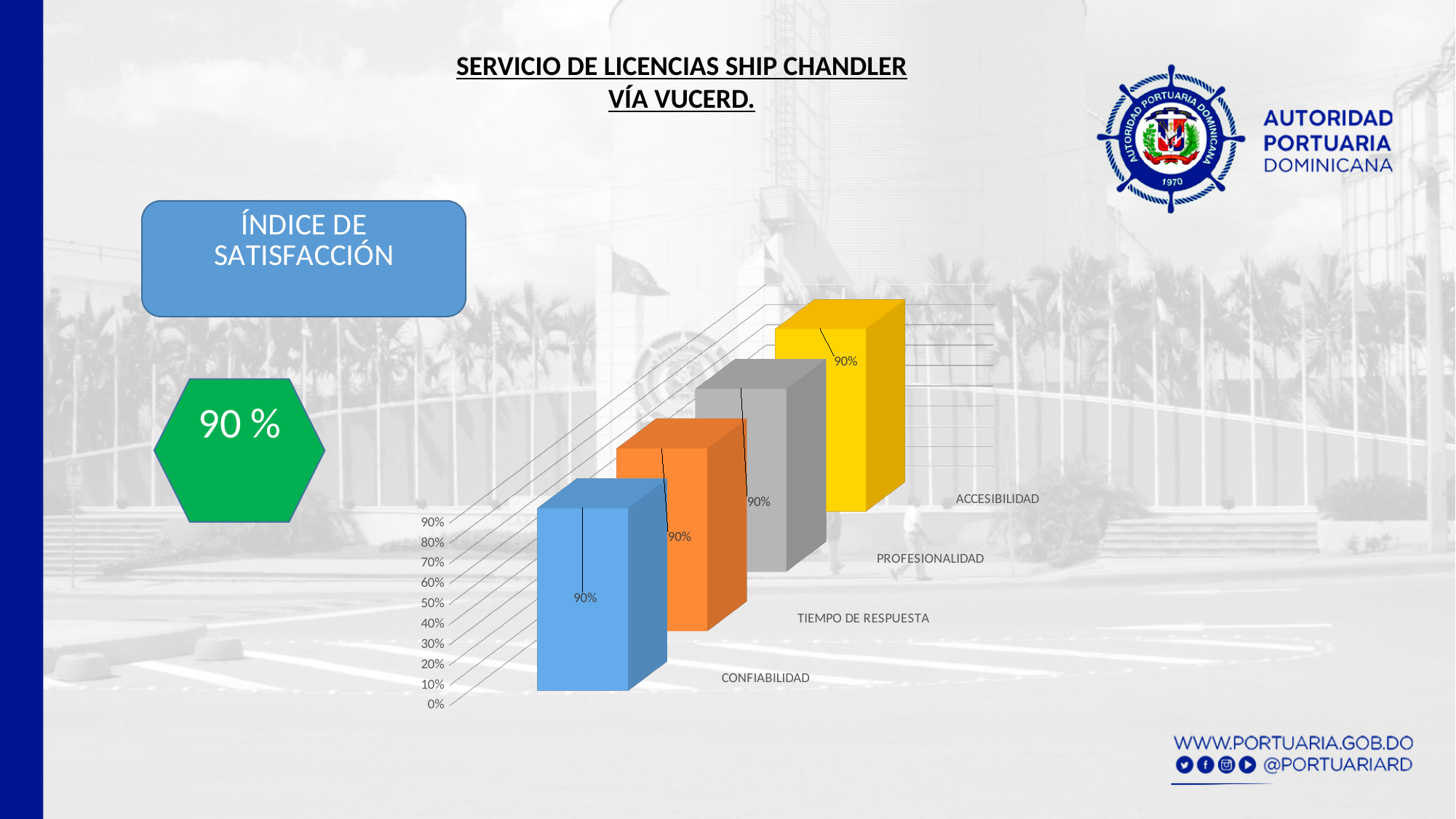
How many categories are plotted in the chart? 4 What is the highest value shown on the vertical axis? 90% What is the difference between the values for ACCESIBILIDAD and CONFIABILIDAD? 0% What is the value for ACCESIBILIDAD? 90% What colour is the bar for CONFIABILIDAD? blue What is the value for TIEMPO DE RESPUESTA? 90% What kind of chart is shown on the slide? bar chart Do the values rise, fall or stay the same across the categories from CONFIABILIDAD to ACCESIBILIDAD? stay the same Is the value for PROFESIONALIDAD greater or less than 50%? greater What is the value for CONFIABILIDAD? 90% What is the value for PROFESIONALIDAD? 90%